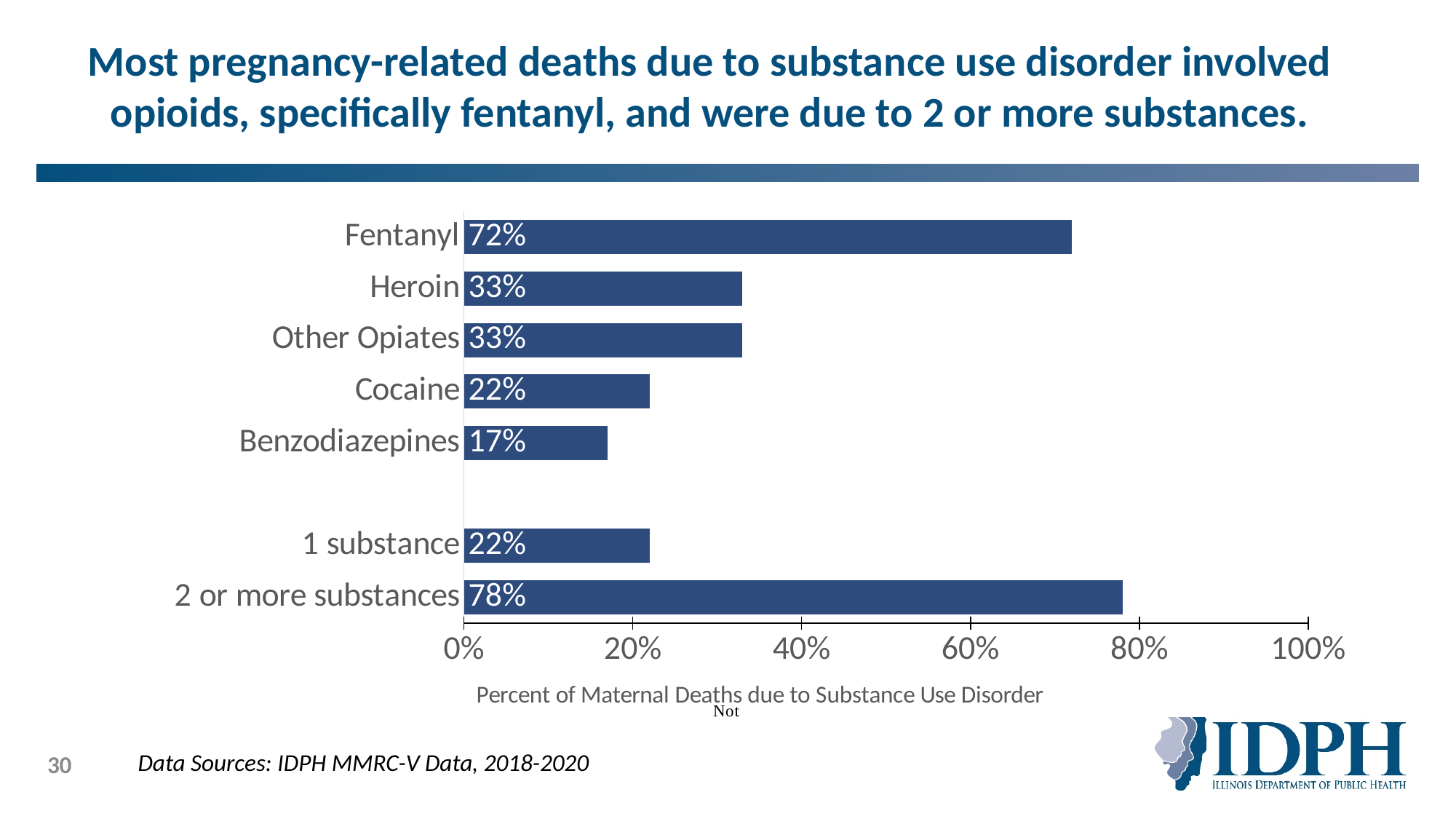
Which category has the highest value on the chart? 2 or more substances Which is larger, the value for Cocaine or the value for Benzodiazepines? Cocaine What kind of chart is shown on the slide? Bar chart What is the difference between the values for 2 or more substances and 1 substance? 56% What percent of deaths involved 2 or more substances? 78% What is the difference between the values for Fentanyl and Heroin? 39% What is the label on the horizontal axis of the chart? Percent of Maternal Deaths due to Substance Use Disorder What percent of maternal deaths due to substance use disorder involved fentanyl? 72% Which category has the lowest value on the chart? Benzodiazepines How many labeled bars are shown on the chart? 7 What is the value shown for Benzodiazepines? 17% What is the value shown for Cocaine? 22%